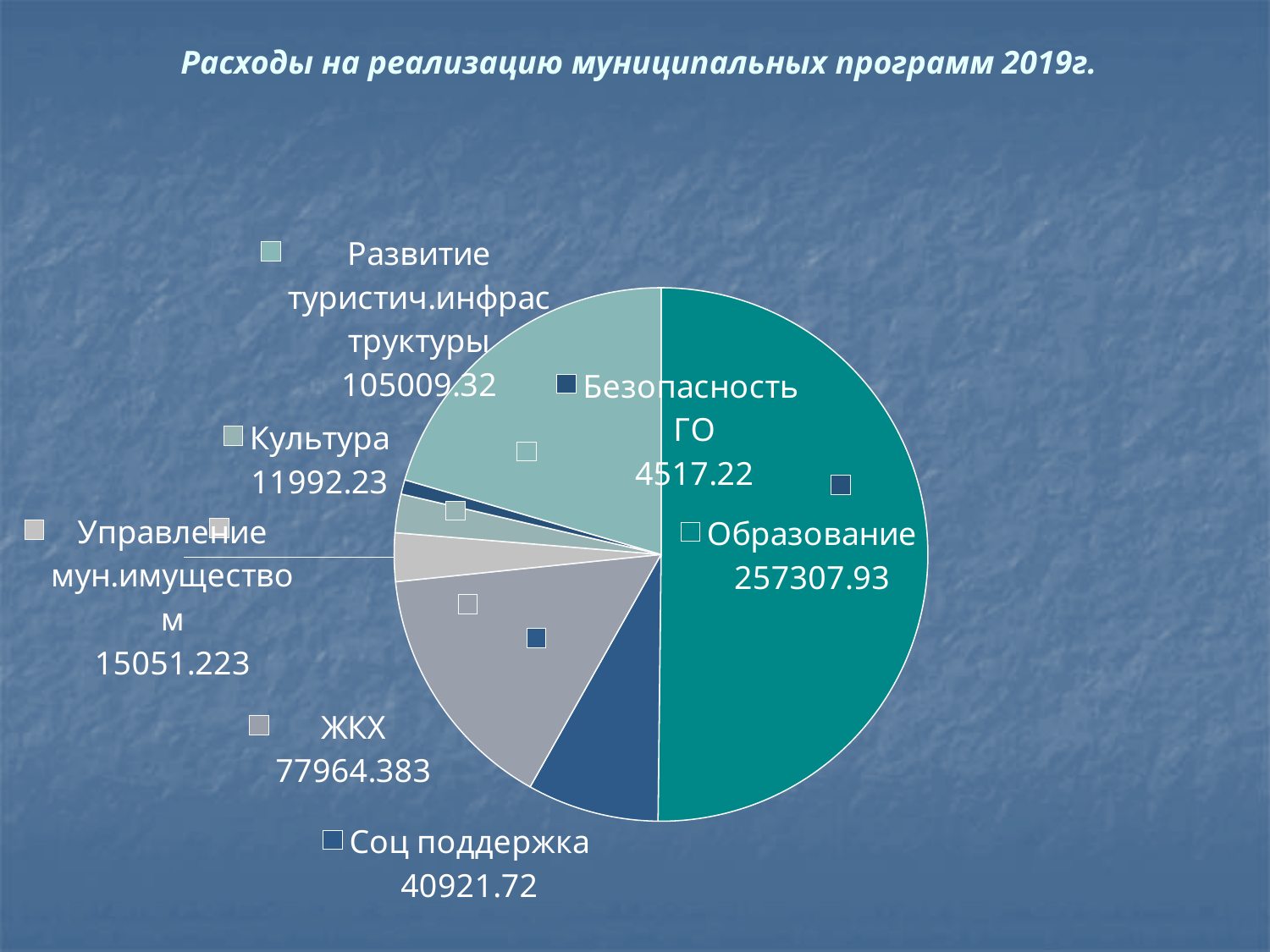
What is the value for Безопасность ГО? 4517.22 What is the value for ЖКХ? 77964.383 Which category has the largest slice? Образование What is the value for Образование? 257307.93 Which category has the smallest slice? Безопасность ГО What kind of chart is shown on the slide? pie chart What is the title of the chart? Расходы на реализацию муниципальных программ 2019г. Which is larger, ЖКХ or Соц поддержка? ЖКХ What is the difference between Образование and Развитие туристич.инфраструктуры? 152298.61 How many categories (slices) does the pie chart have? 7 What is the value for Управление мун.имуществом? 15051.223 What is the value for Соц поддержка? 40921.72